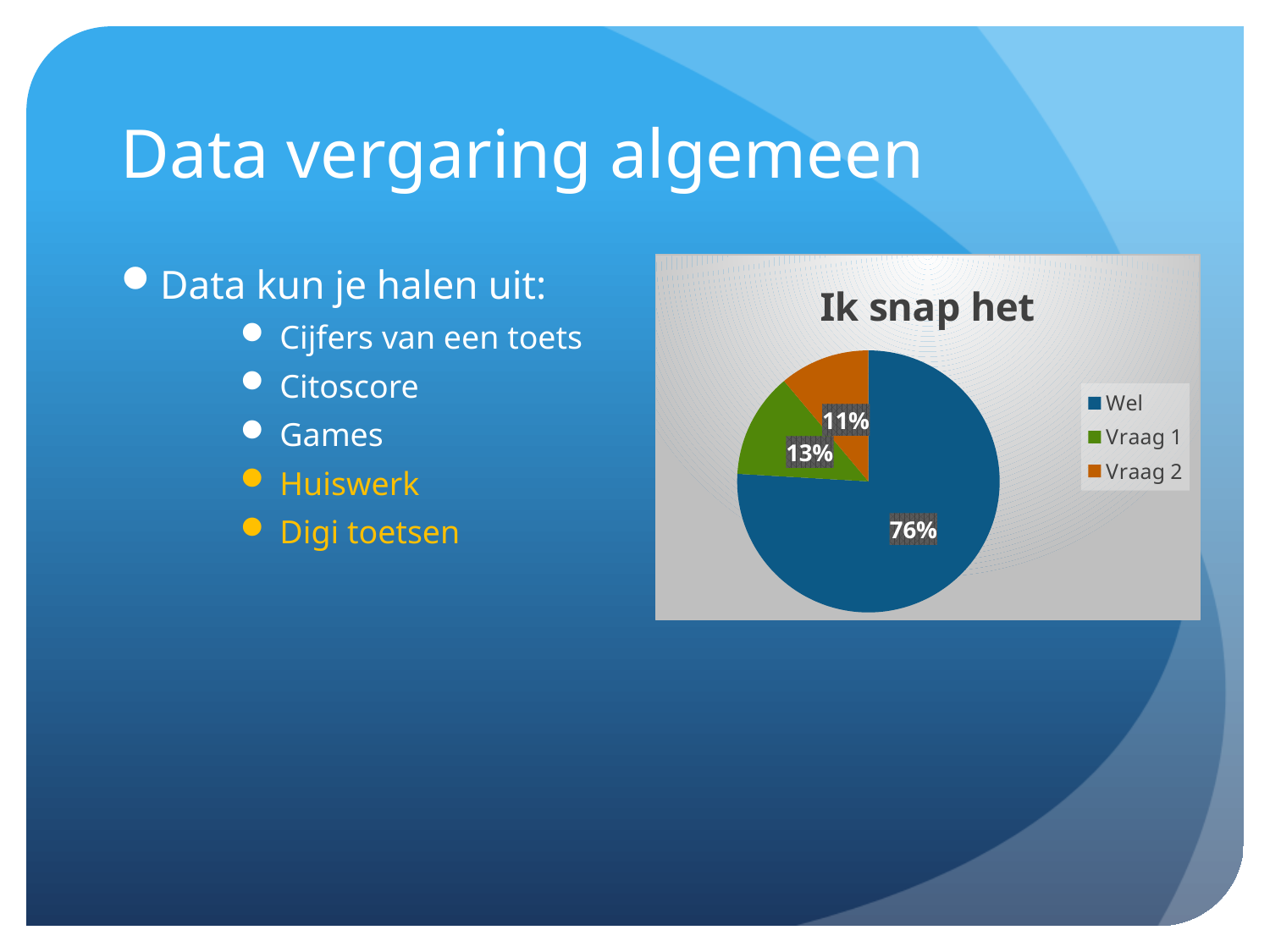
How many slices does the pie chart have? 3 What percentage of the pie does the 'Vraag 2' slice represent? 11% What is the title of the chart? Ik snap het Which slice of the pie is the largest? Wel What kind of chart is shown on the slide? pie chart Which is larger, the 'Vraag 1' slice or the 'Vraag 2' slice? Vraag 1 Which slice of the pie is the smallest? Vraag 2 How many entries does the legend list? 3 What is the difference in percentage points between the 'Wel' slice and the 'Vraag 1' slice? 63 What percentage of the pie does the 'Wel' slice represent? 76% What colour is the 'Wel' slice in the pie chart? blue What percentage of the pie does the 'Vraag 1' slice represent? 13%